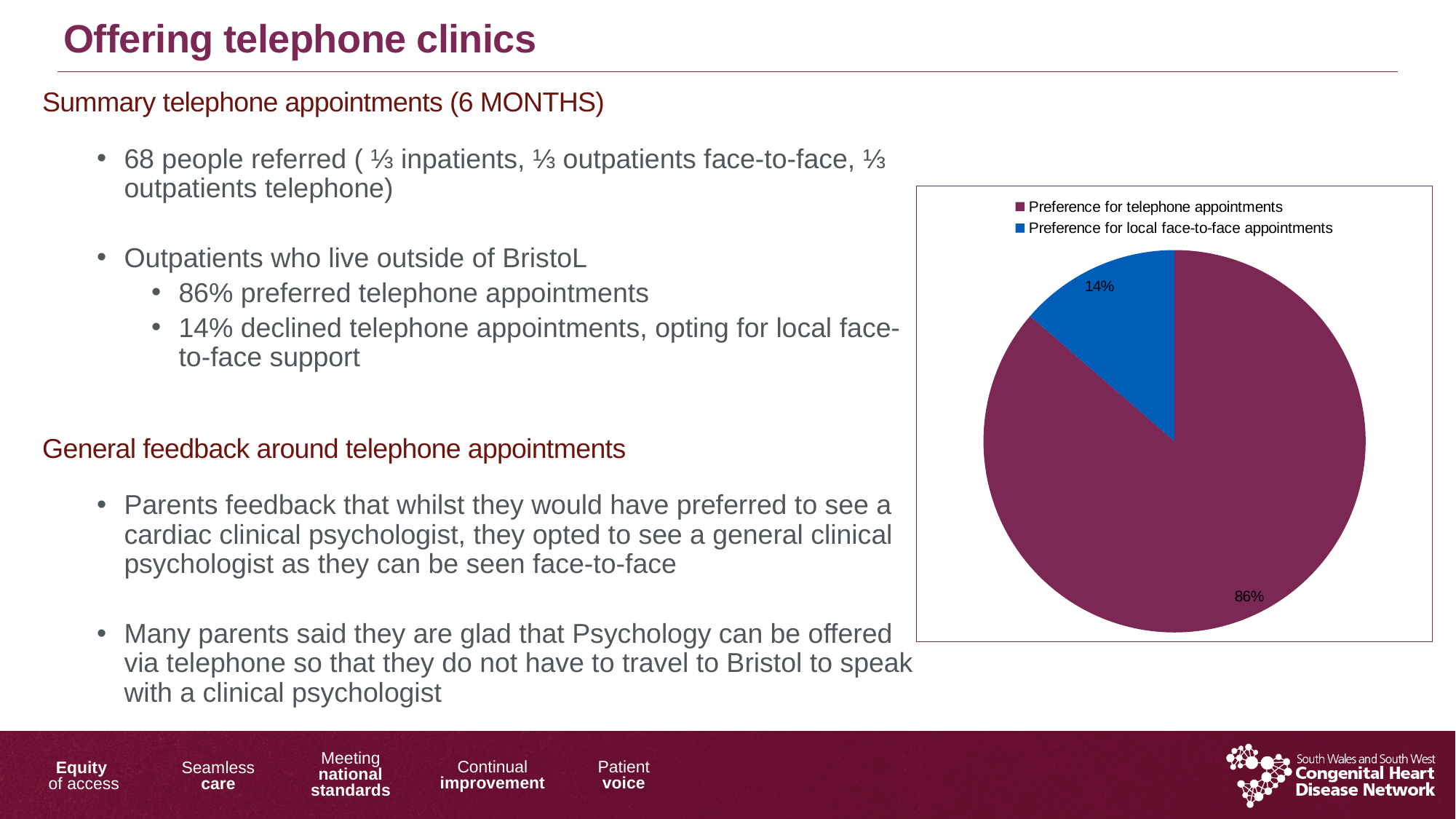
What colour is the slice for preference for telephone appointments in the pie chart? Purple How many slices does the pie chart have? 2 What percentage of the pie chart is labelled for preference for local face-to-face appointments? 14% What is the difference in percentage points between the telephone appointments slice and the local face-to-face appointments slice? 72 What colour is the slice for preference for local face-to-face appointments in the pie chart? Blue What kind of chart is shown on the slide? Pie chart What percentage of the pie chart is labelled for preference for telephone appointments? 86% Which slice of the pie chart is the largest? Preference for telephone appointments How many entries does the pie chart legend list? 2 Which slice of the pie chart is the smallest? Preference for local face-to-face appointments Which is larger in the pie chart: preference for telephone appointments or preference for local face-to-face appointments? Preference for telephone appointments